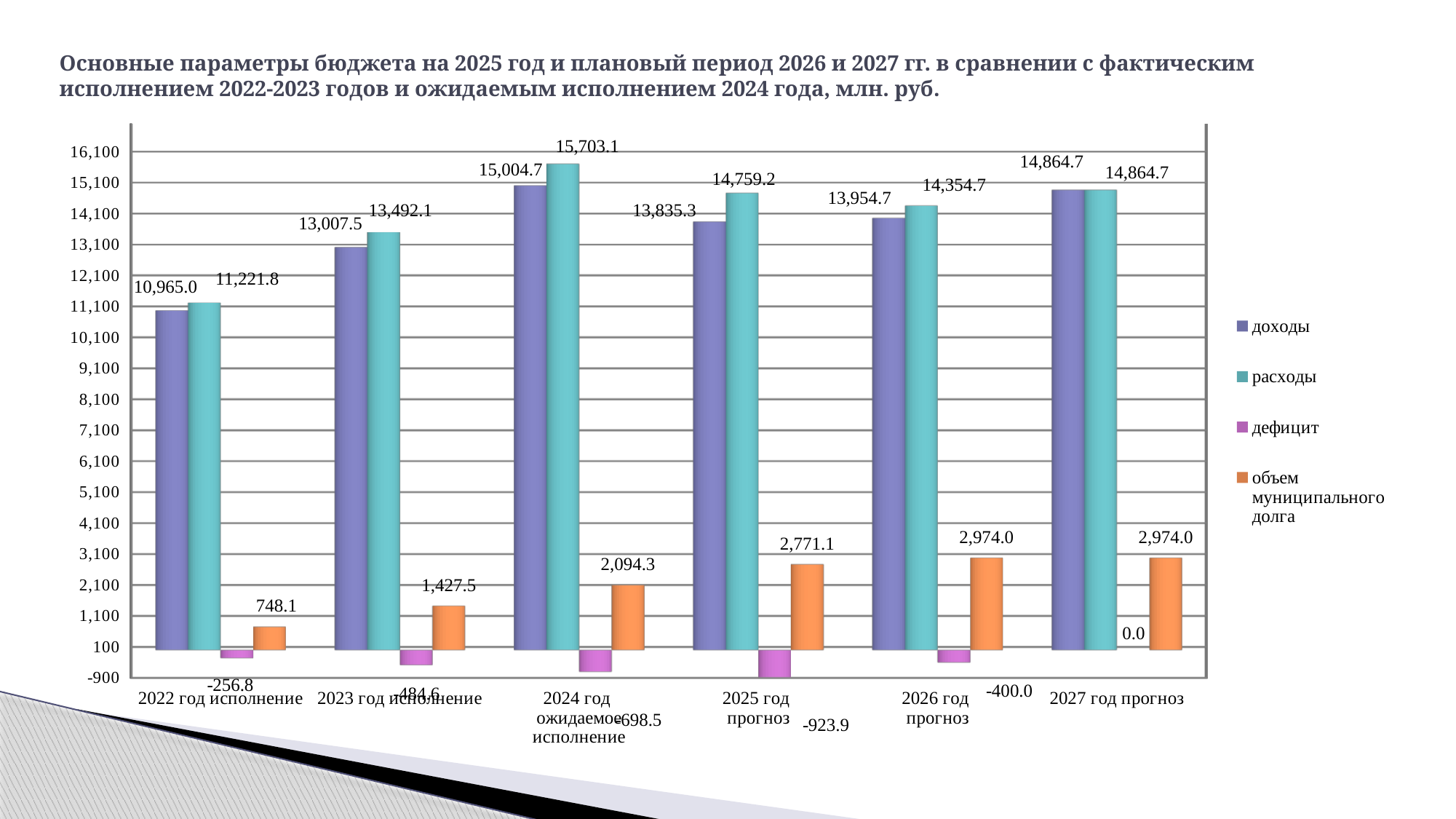
How many series does the legend list? 4 What is the difference between расходы and доходы for 2025 год прогноз? 923.9 What is the value of дефицит for 2026 год прогноз? -400.0 What is the value of объем муниципального долга for 2024 год ожидаемое исполнение? 2,094.3 What is the value of доходы for 2022 год исполнение? 10,965.0 In which category is расходы the highest? 2024 год ожидаемое исполнение Does объем муниципального долга rise or fall from 2022 год исполнение to 2026 год прогноз? rise What is the value of расходы for 2025 год прогноз? 14,759.2 How many categories are shown on the x axis? 6 In which category is доходы the lowest? 2022 год исполнение What kind of chart is shown on the slide? bar chart Which is larger for 2023 год исполнение: доходы or расходы? расходы